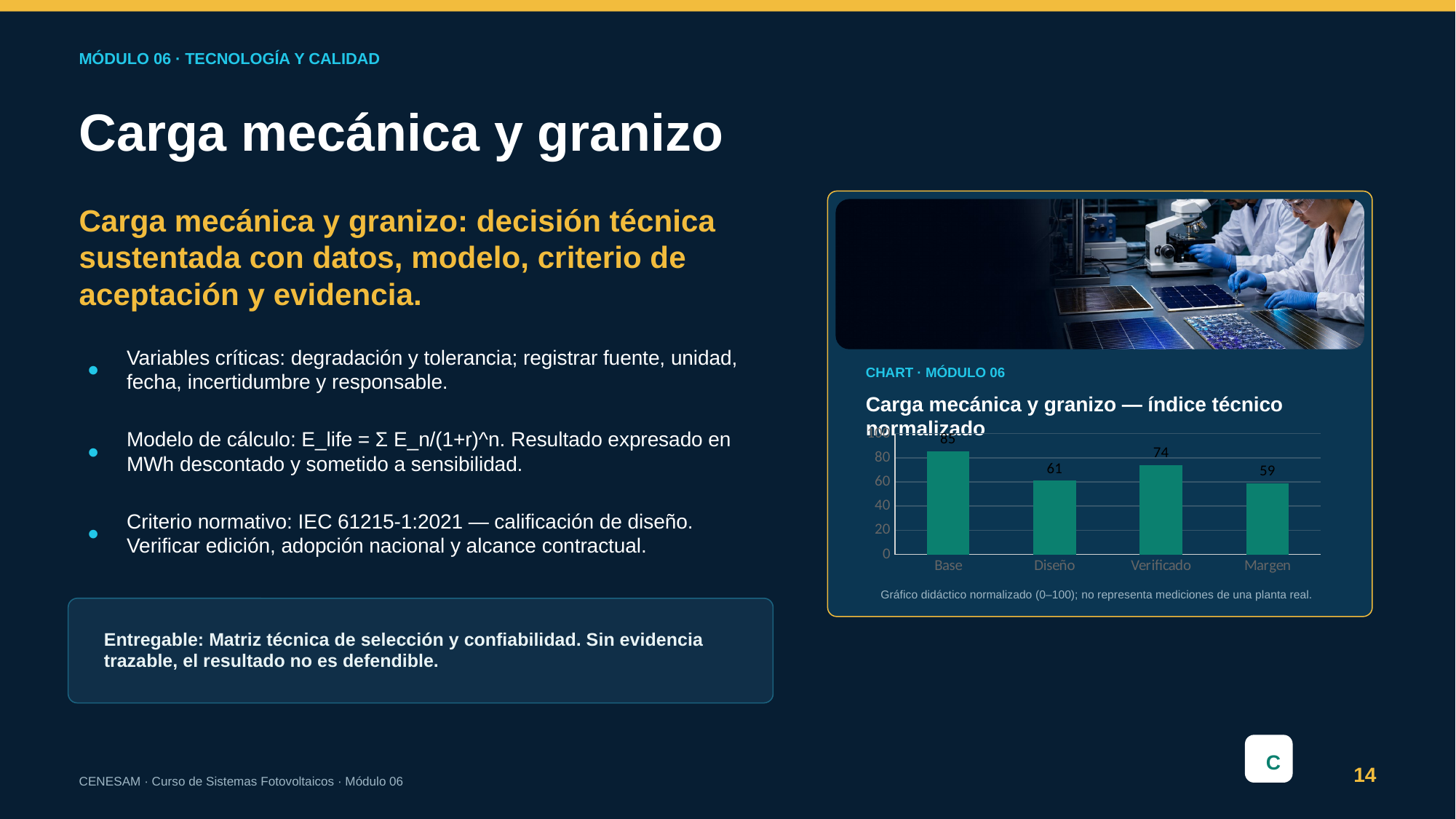
What is the title of the chart? Carga mecánica y granizo — índice técnico normalizado What kind of chart is shown? bar chart Is the value for Diseño greater or less than 80? less What is the value for Diseño? 61 What is the value for Base? 85 What is the value for Verificado? 74 What is the value for Margen? 59 How many categories are shown on the x axis? 4 Which category has the lowest value? Margen Which category has the highest value? Base What is the difference between the values for Base and Diseño? 24 Which is larger, the value for Verificado or the value for Margen? Verificado